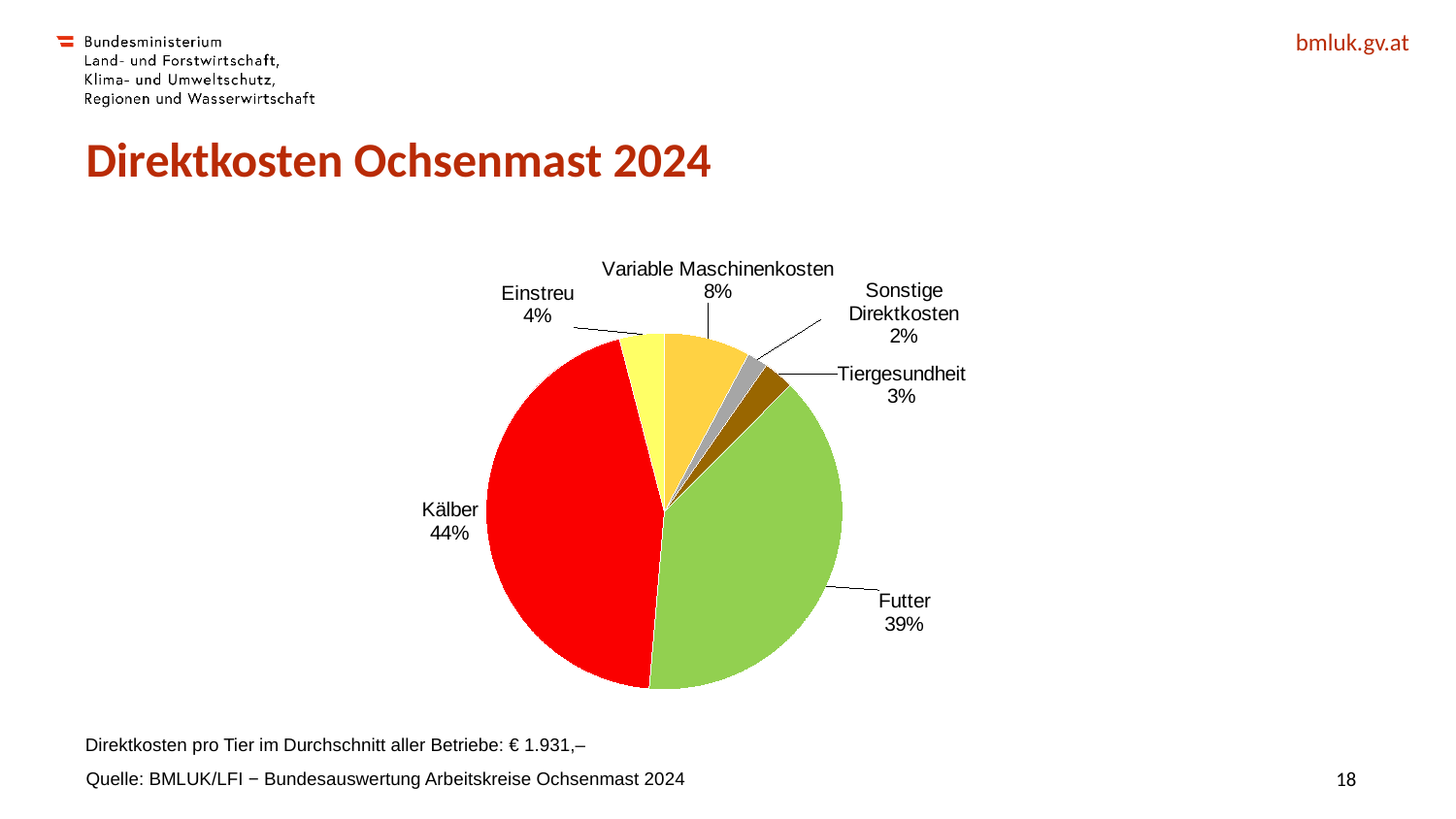
What kind of chart is shown on the slide? Pie chart What is the value shown for Tiergesundheit? 3% Which category has the smallest slice of the pie? Sonstige Direktkosten What is the value shown for Einstreu? 4% Which category has the largest slice of the pie? Kälber Which is larger, Einstreu or Variable Maschinenkosten? Variable Maschinenkosten What share of the pie does Kälber account for? 44% What is the difference in percentage points between Kälber and Futter? 5 What is the value shown for Variable Maschinenkosten? 8% What is the title of the slide containing the chart? Direktkosten Ochsenmast 2024 What share of the pie does Futter account for? 39% How many categories are shown in the pie chart? 6